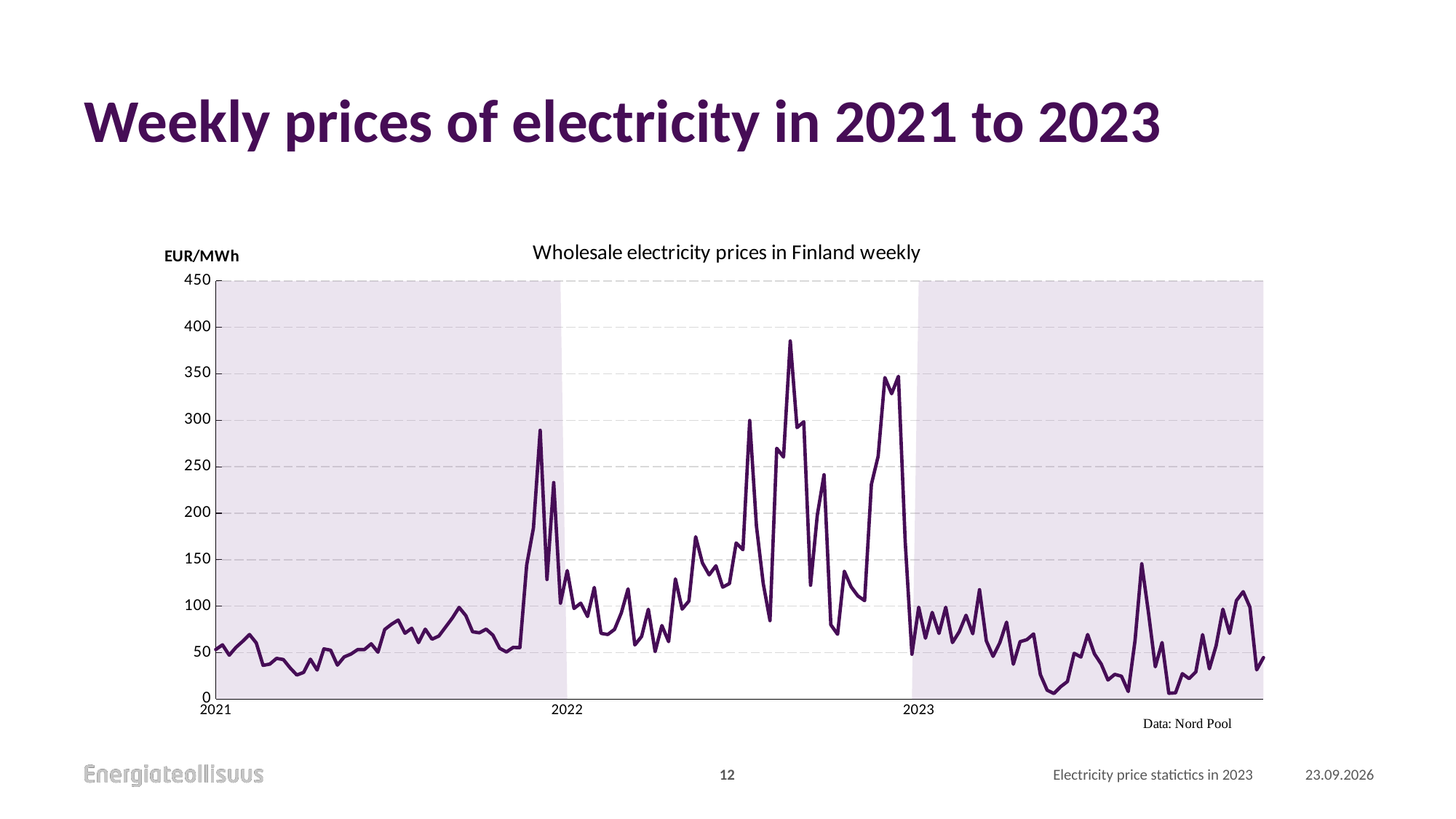
How many year labels are shown on the x axis of the chart? 3 Is the highest weekly price in 2022 greater or less than 350 EUR/MWh? greater What kind of chart is shown on the slide? line chart Is the highest weekly price in 2023 greater or less than 200 EUR/MWh? less Which year has the higher peak weekly price, 2021 or 2023? 2021 In which year does the chart reach its highest weekly price? 2022 Is the peak weekly price near the end of 2021 greater or less than 250 EUR/MWh? greater What unit is shown on the vertical axis of the chart? EUR/MWh What is the title of the chart? Wholesale electricity prices in Finland weekly What is the highest value shown on the vertical axis of the chart? 450 Is the weekly price at the end of 2023 higher or lower than at the start of 2023? lower